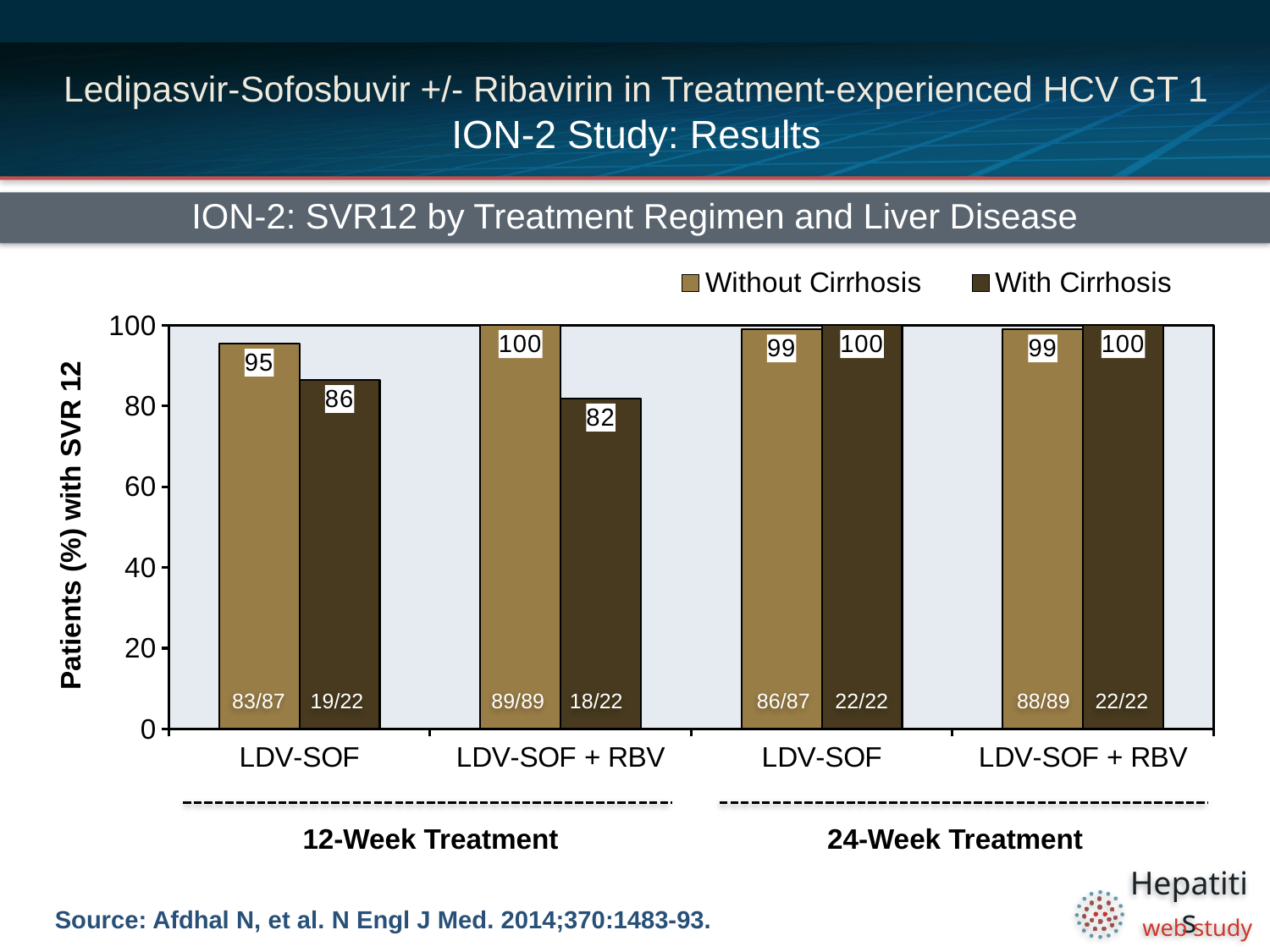
Which bar has the lowest SVR12 value on the chart? With Cirrhosis, LDV-SOF + RBV, 12-Week Treatment Which series is shown in the darker brown colour? With Cirrhosis What is the SVR12 rate for patients with cirrhosis receiving LDV-SOF + RBV for 12 weeks? 82 How many treatment regimen categories are shown on the x axis? 4 In the 12-week LDV-SOF group, which is higher: the SVR12 for patients without cirrhosis or with cirrhosis? Without Cirrhosis How many series does the legend list? 2 What is the SVR12 rate for patients without cirrhosis receiving LDV-SOF for 12 weeks? 95 What kind of chart is shown on the slide? Bar chart What is the label of the y axis? Patients (%) with SVR 12 What is the difference in SVR12 between patients without cirrhosis and with cirrhosis in the 12-week LDV-SOF + RBV group? 18 What is the SVR12 rate for patients with cirrhosis receiving LDV-SOF for 24 weeks? 100 What fraction of patients is shown inside the With Cirrhosis bar for LDV-SOF in the 12-week treatment group? 19/22